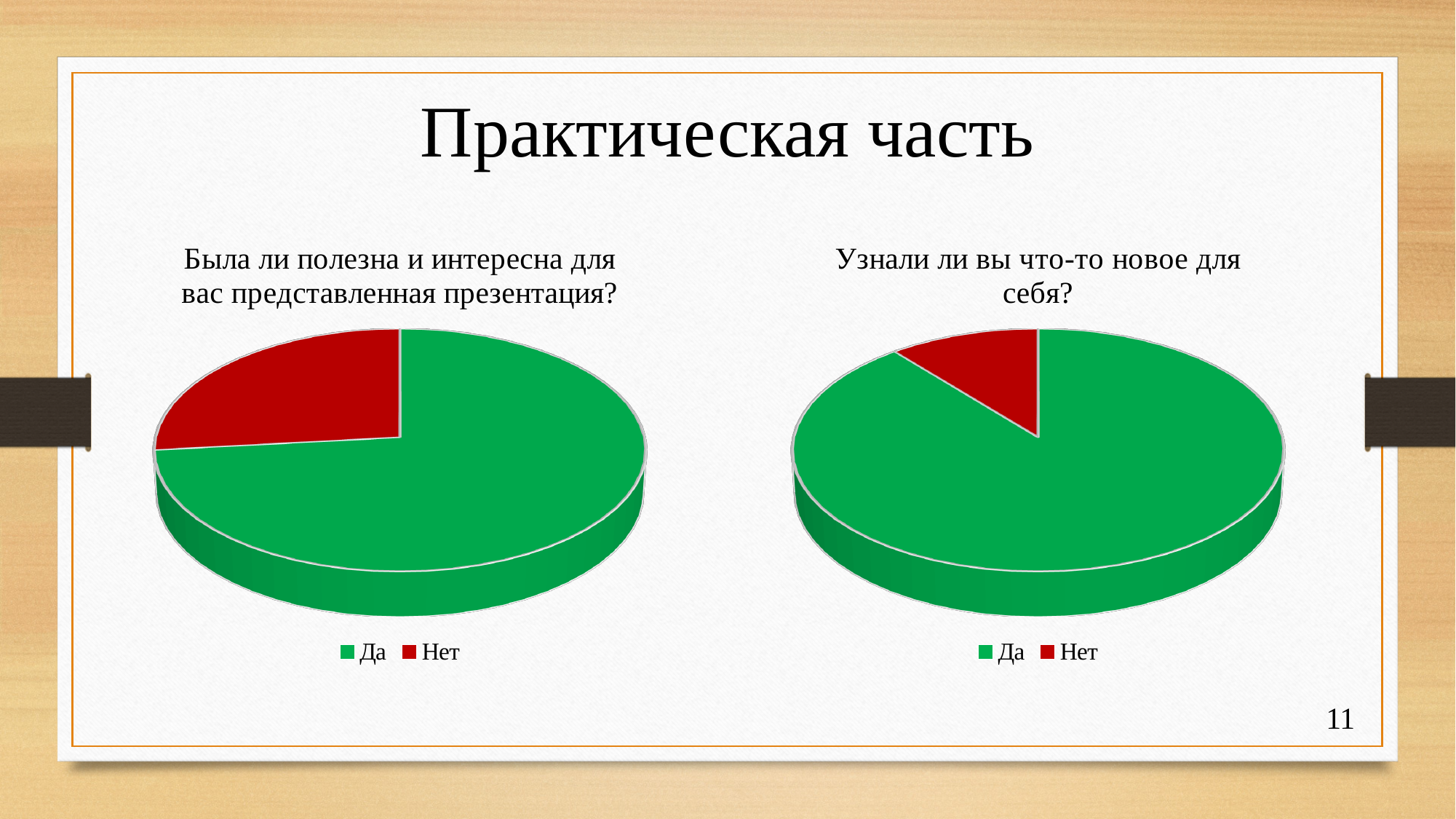
What kind of chart is the right chart titled "Узнали ли вы что-то новое для себя?"? Pie chart How many entries does the legend of the right chart "Узнали ли вы что-то новое для себя?" list? 2 What is the title of the left chart? Была ли полезна и интересна для вас представленная презентация? Which chart has the larger Нет slice, the left chart or the right chart? The left chart In the right chart "Узнали ли вы что-то новое для себя?", which category has the largest slice? Да In the left chart "Была ли полезна и интересна для вас представленная презентация?", which category has the largest slice? Да How many categories does the left chart "Была ли полезна и интересна для вас представленная презентация?" show? 2 What kind of chart is the left chart titled "Была ли полезна и интересна для вас представленная презентация?"? Pie chart In the right chart "Узнали ли вы что-то новое для себя?", which category has the smallest slice? Нет In the right chart "Узнали ли вы что-то новое для себя?", what colour is the Нет slice? Red In the left chart "Была ли полезна и интересна для вас представленная презентация?", which slice is larger, Да or Нет? Да In the left chart "Была ли полезна и интересна для вас представленная презентация?", which category has the smallest slice? Нет